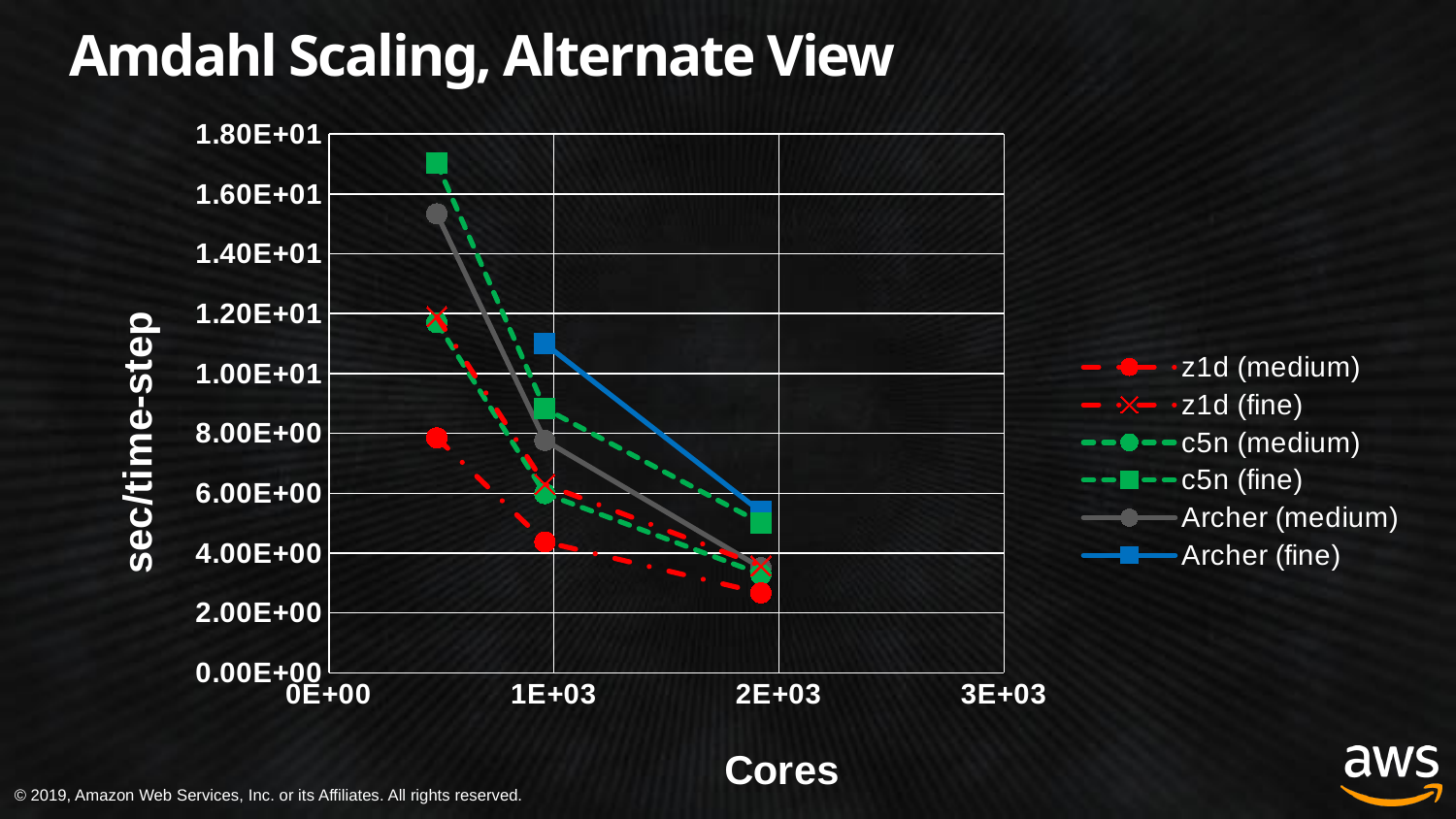
What is the label of the y axis? sec/time-step Which series has the highest value at its first plotted point? c5n (fine) Is the first plotted value for Archer (medium) greater or less than 1.40E+01? greater Do the values for c5n (fine) rise or fall as the number of cores increases? fall Is the last plotted value for z1d (medium) greater or less than 4.00E+00? less What kind of chart is shown on the slide? line chart What is the title of the chart? Amdahl Scaling, Alternate View Is the first plotted value for c5n (fine) greater or less than 1.60E+01? greater How many series does the legend list? 6 Do the values for Archer (medium) rise or fall along the x axis? fall At the first plotted point, which is larger: c5n (fine) or z1d (medium)? c5n (fine)